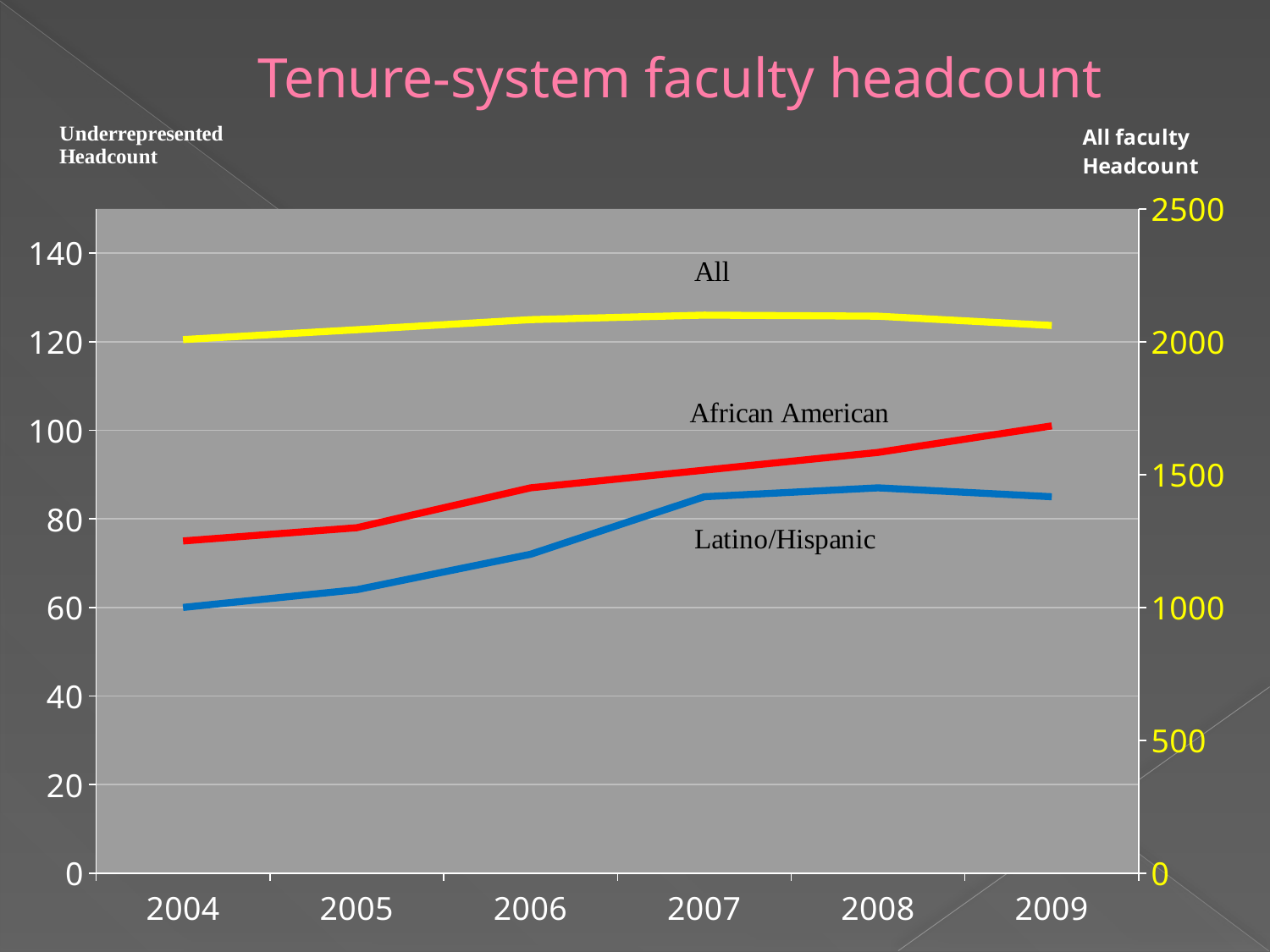
In which year is the African American headcount highest? 2009 What kind of chart is shown on the slide? line chart How many lines (series) are plotted on the chart? 3 In which year is the Latino/Hispanic headcount lowest? 2004 Is the All faculty headcount in 2007 greater or less than 2000? greater What is the title of the chart? Tenure-system faculty headcount How many years are plotted along the x axis? 6 Which series is plotted against the right-hand 'All faculty Headcount' axis? All Does the African American headcount rise or fall from 2004 to 2009? rise Is the Latino/Hispanic headcount in 2009 greater or less than 80? greater Is the African American headcount in 2004 greater or less than 80? less In 2006, which is larger: the African American headcount or the Latino/Hispanic headcount? African American